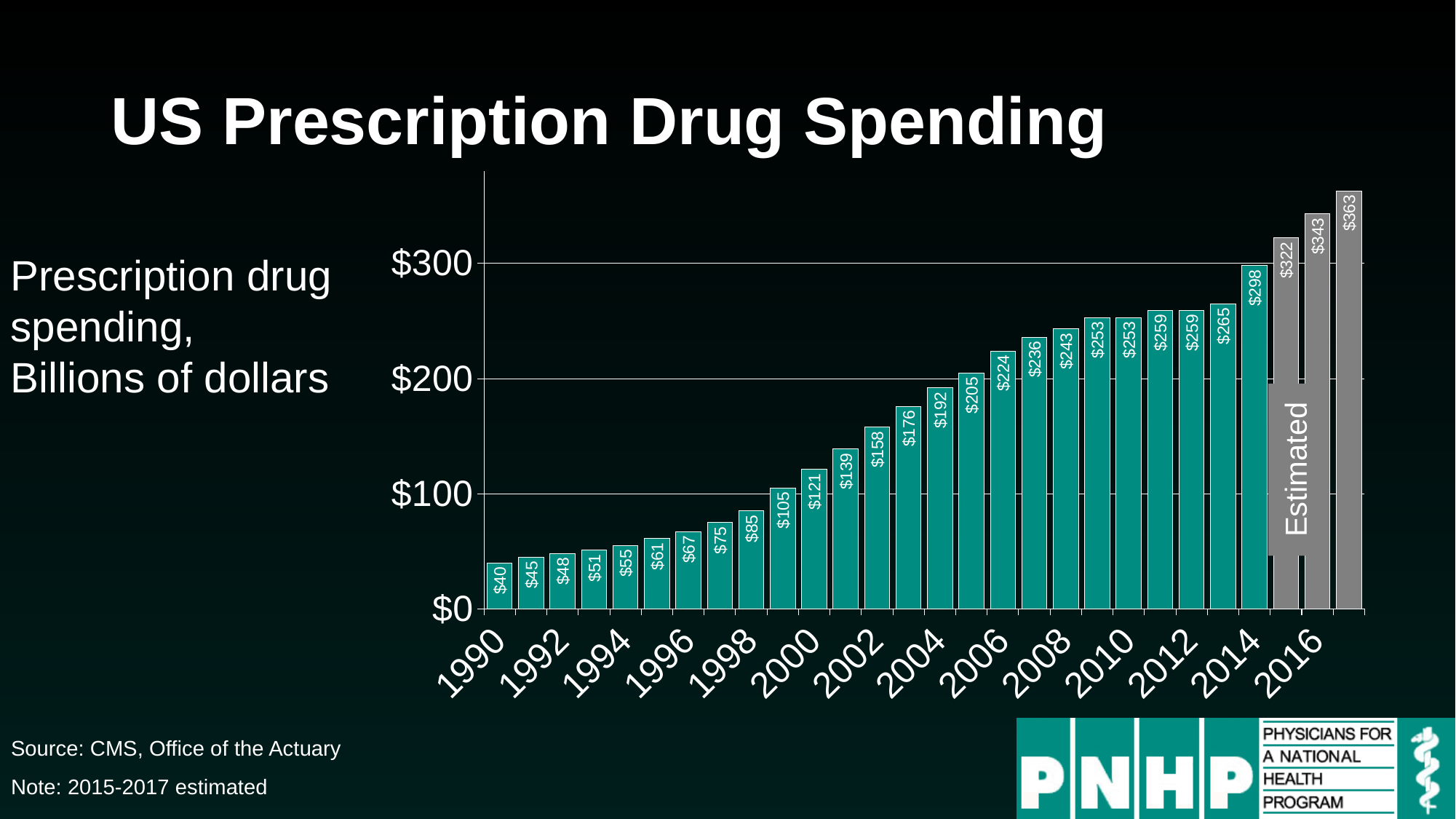
What was US prescription drug spending in 2000? $121 Is the value for 2004 greater or less than $200? less What is the overall trend of prescription drug spending from 1990 to 2017? rising What is the estimated US prescription drug spending for 2016? $343 Which year has the highest prescription drug spending on the chart? 2017 Which year has higher prescription drug spending, 2006 or 2008? 2008 What is the difference between the 2017 estimate and the 2014 value? $65 What type of chart is shown on the slide? bar chart What was US prescription drug spending in 2014? $298 What was US prescription drug spending in 1990? $40 Which year has the lowest prescription drug spending on the chart? 1990 How much higher is prescription drug spending in 2010 than in 2000? $132